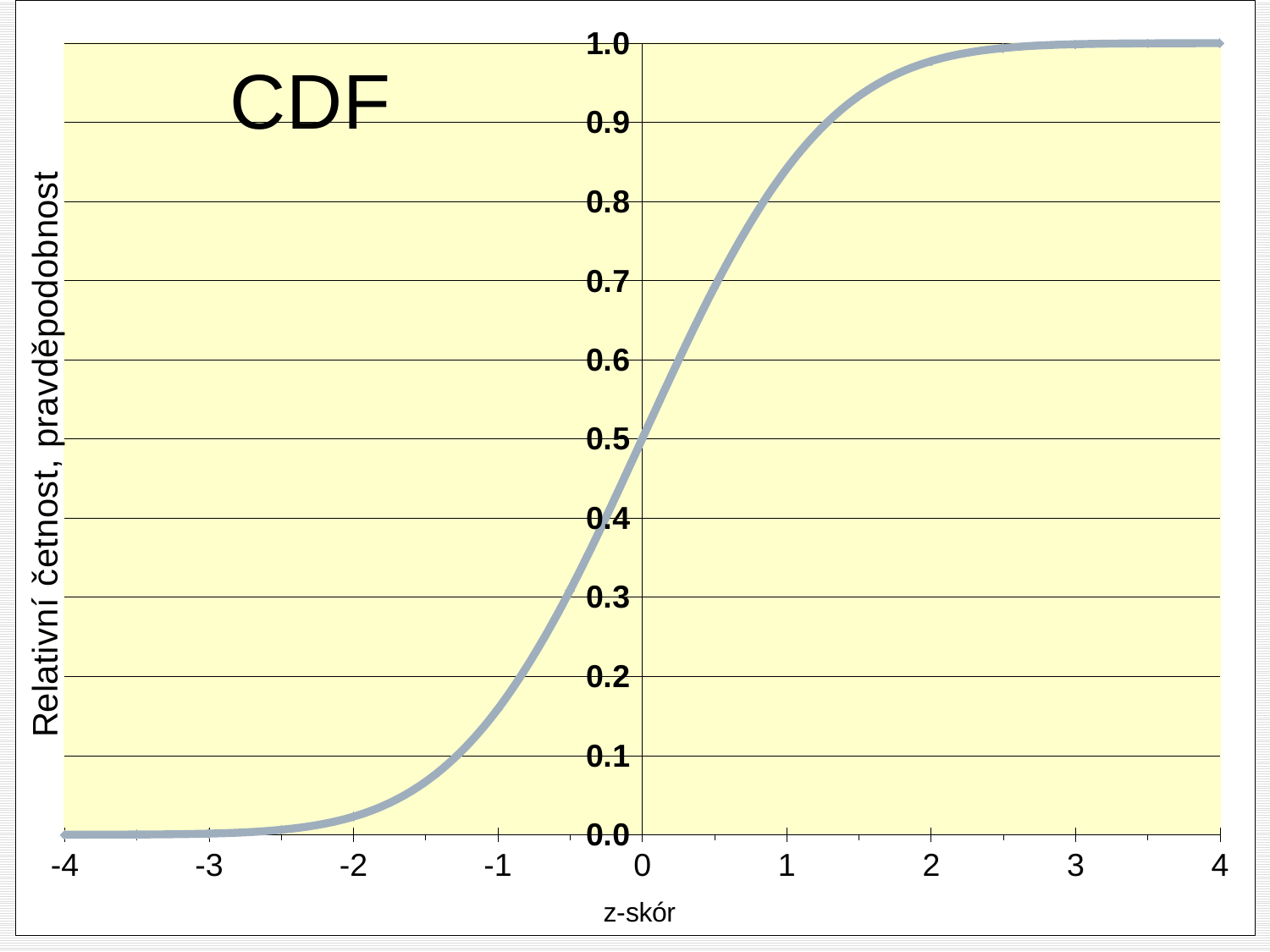
Is the value of the curve at z-skór -1 greater or less than 0.2? less What is the value of the curve at z-skór 0? 0.5 What is the value of the curve at z-skór -4? 0.0 What is the label of the x axis? z-skór What is the title of the chart? CDF Which is larger, the value of the curve at z-skór 1 or at z-skór -1? z-skór 1 What kind of chart is shown on the slide? line chart Is the value of the curve at z-skór 2 greater or less than 0.9? greater Is the value of the curve at z-skór -2 greater or less than 0.1? less What is the value of the curve at z-skór 4? 1.0 Do the values of the curve rise or fall as the z-skór increases from -4 to 4? rise